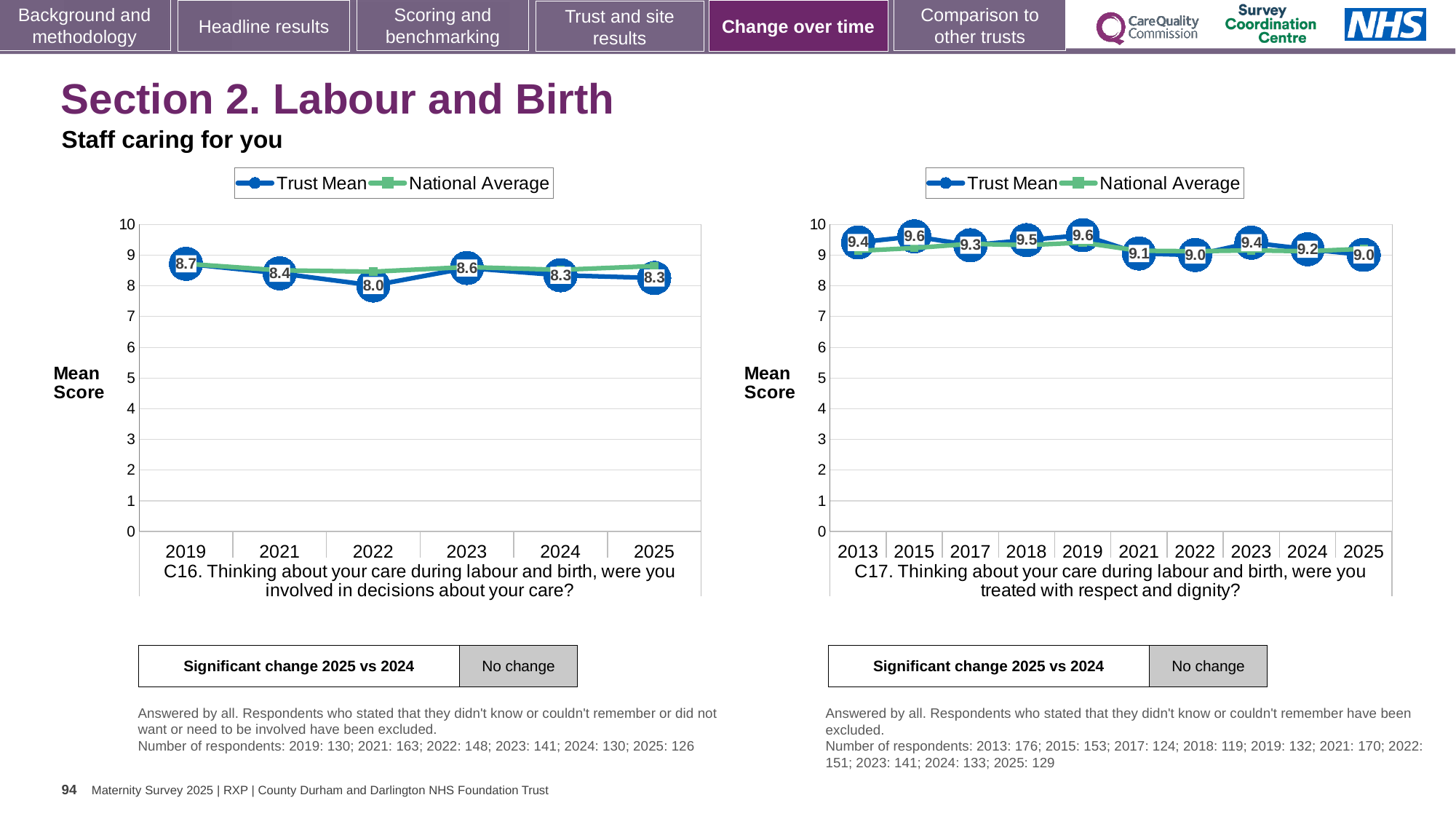
In the C16 chart on the left, what is the Trust Mean score for 2019? 8.7 In the C16 chart on the left, which year has the highest Trust Mean score? 2019 In the C16 chart on the left, which year has the lowest Trust Mean score? 2022 In the C17 chart on the right, which is larger: the Trust Mean score for 2015 or for 2022? 2015 In the C16 chart on the left, what is the difference between the Trust Mean scores for 2019 and 2022? 0.7 How many series does the legend of the C16 chart on the left list? 2 In the C17 chart on the right, what is the Trust Mean score for 2025? 9.0 What kind of chart is the C17 chart on the right? Line chart In the C17 chart on the right, what is the Trust Mean score for 2021? 9.1 In the C16 chart on the left, is the National Average value for 2022 greater or less than 8? greater How many years are shown on the x axis of the C17 chart on the right? 10 In the C16 chart on the left, what is the Trust Mean score for 2022? 8.0